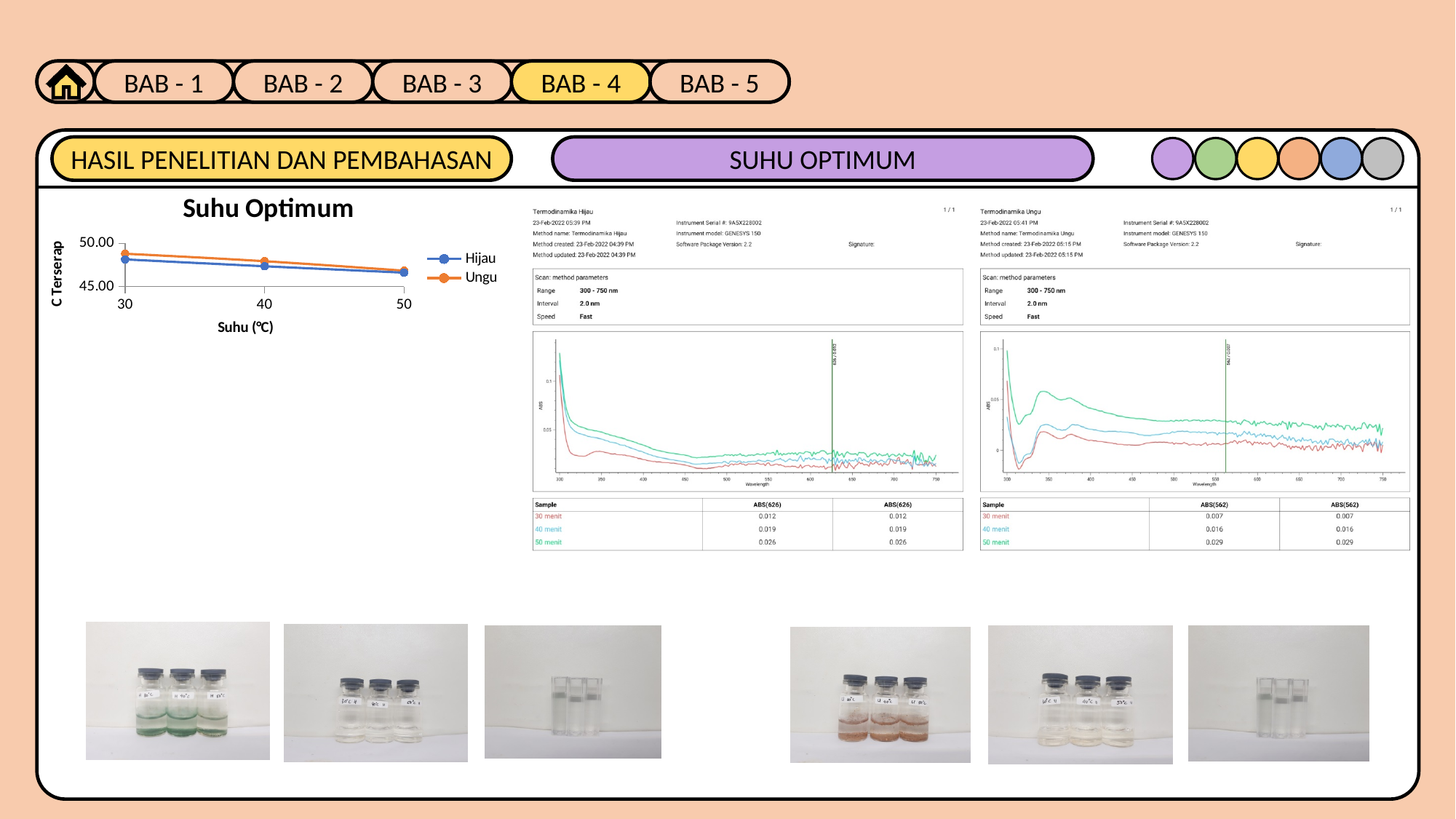
What type of chart is the 'Suhu Optimum' chart on the left of the slide? Line chart In the 'Termodinamika Hijau' report table, what is the ABS(626) value for the 50 menit sample? 0.026 In the 'Suhu Optimum' chart, do the values for Hijau rise or fall as Suhu increases from 30 to 50? Fall How many temperature points are plotted along the x axis of the 'Suhu Optimum' chart? 3 In the 'Suhu Optimum' chart, do the values for Ungu rise or fall as Suhu increases from 30 to 50? Fall How many series does the legend of the 'Suhu Optimum' chart list? 2 In the 'Suhu Optimum' chart, which series has the higher value at Suhu 30, Hijau or Ungu? Ungu In the 'Suhu Optimum' chart, is the value for Ungu at Suhu 30 greater or less than 50.00? less What are the names of the two series in the 'Suhu Optimum' chart? Hijau and Ungu In the 'Termodinamika Ungu' report table, what is the ABS(562) value for the 30 menit sample? 0.007 In the 'Suhu Optimum' chart, is the value for Hijau at Suhu 30 greater or less than 45.00? greater What is the label of the x axis of the 'Suhu Optimum' chart? Suhu (℃)